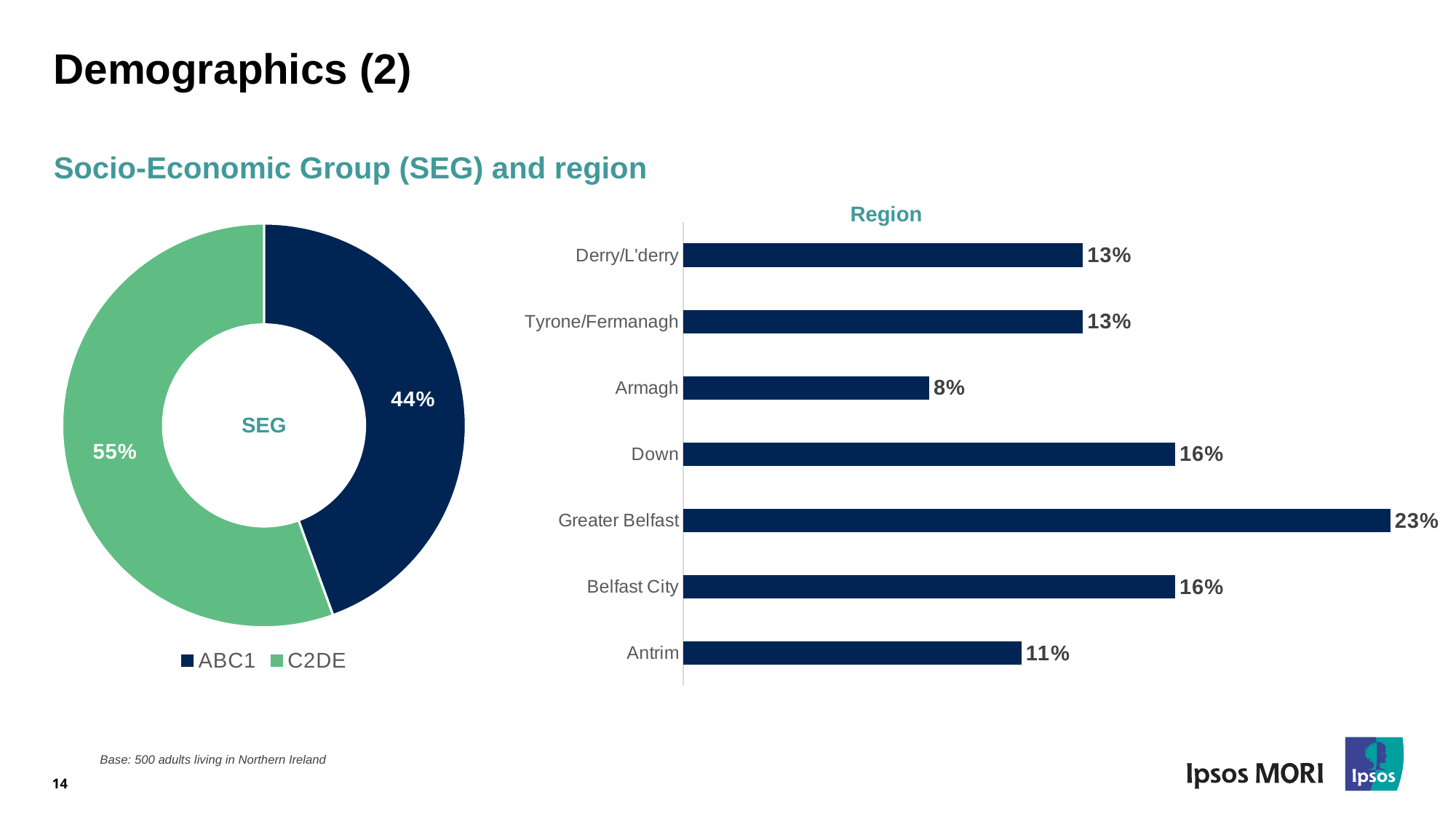
In the Region chart, what is the value for Greater Belfast? 23% What kind of chart is the SEG chart? Pie chart (doughnut) In the Region chart, what is the difference between Greater Belfast and Antrim? 12% In the Region chart, what is the value for Armagh? 8% In the SEG chart, what percentage is ABC1? 44% In the SEG chart, what is the difference between the C2DE and ABC1 shares? 11% How many regions are shown in the Region chart? 7 In the SEG chart, which group has the larger share, ABC1 or C2DE? C2DE In the Region chart, which region has the highest value? Greater Belfast In the SEG chart, what percentage is C2DE? 55% In the Region chart, which region has the lowest value? Armagh What kind of chart is the Region chart? Bar chart